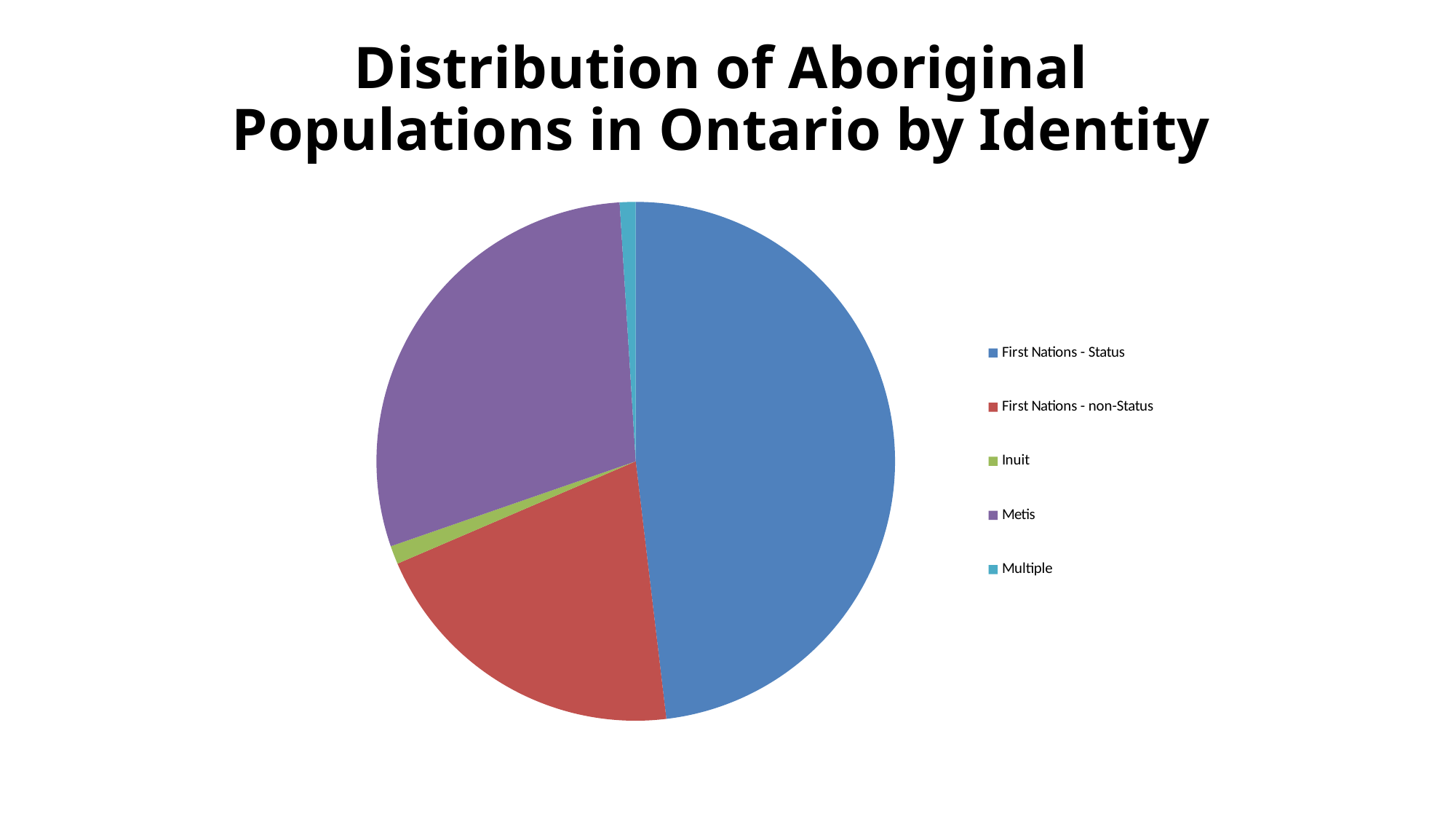
Which slice is larger, First Nations - non-Status or Inuit? First Nations - non-Status Which slice is larger, First Nations - Status or Metis? First Nations - Status What kind of chart is shown on the slide? Pie chart How many categories (slices) does the pie chart have? 5 Which category has the largest slice of the pie? First Nations - Status What is the title of the chart? Distribution of Aboriginal Populations in Ontario by Identity Which slice is larger, Metis or Multiple? Metis What colour is the Metis slice in the pie chart? Purple How many entries does the legend list? 5